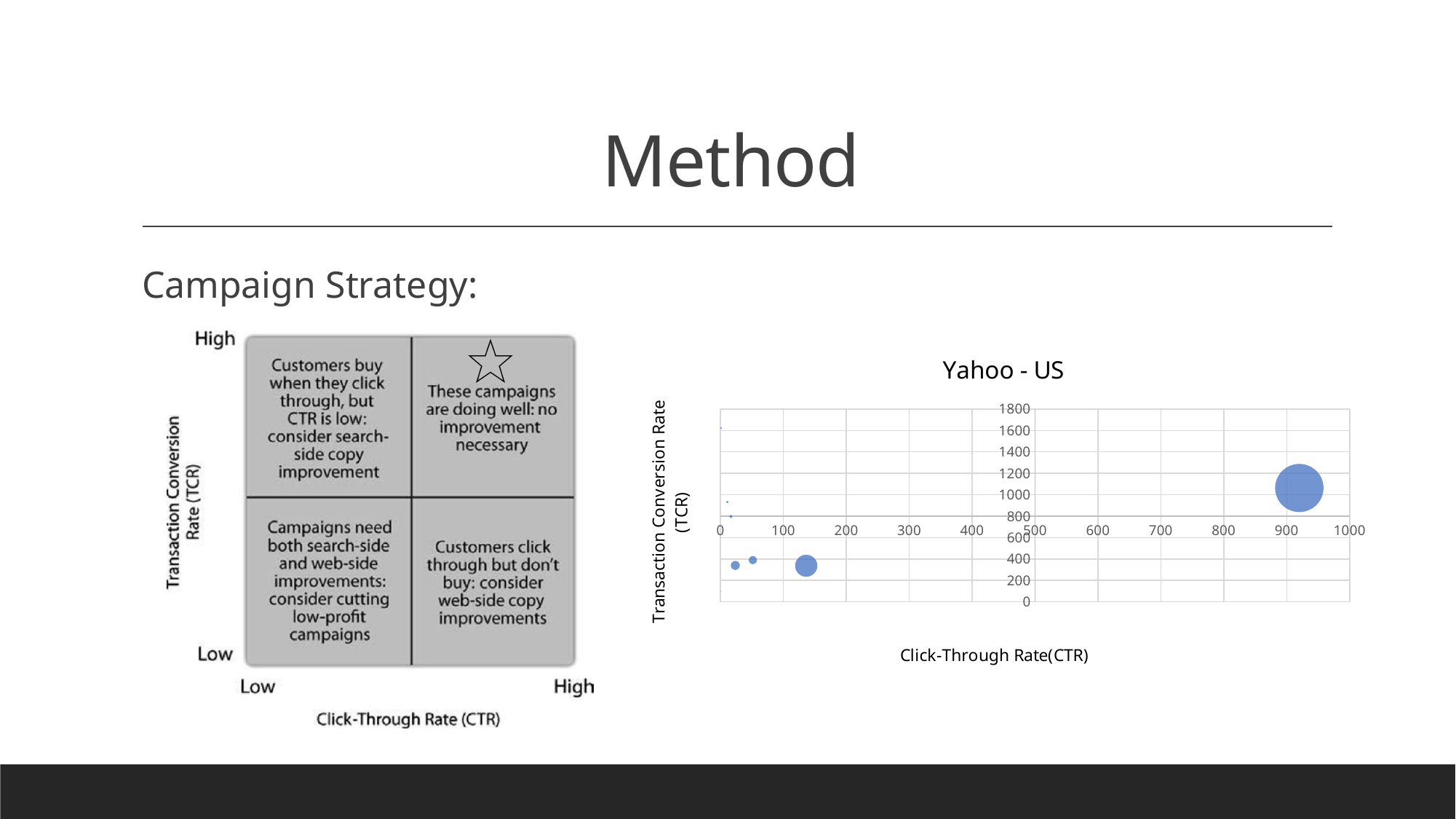
What kind of chart is the "Yahoo - US" chart? bubble chart In the "Yahoo - US" chart, is the Transaction Conversion Rate of the largest bubble greater or less than 1400? less In the "Yahoo - US" chart, what is the label of the horizontal axis? Click-Through Rate(CTR) In the "Yahoo - US" chart, is the Click-Through Rate of the second-largest bubble greater or less than 200? less In the "Yahoo - US" chart, is the Transaction Conversion Rate of the largest bubble greater or less than 800? greater In the "Yahoo - US" chart, which bubble has the higher Transaction Conversion Rate: the largest bubble or the second-largest bubble? the largest bubble What is the title of the chart on the right side of the slide? Yahoo - US In the "Yahoo - US" chart, which bubble has the higher Click-Through Rate: the largest bubble or the second-largest bubble? the largest bubble